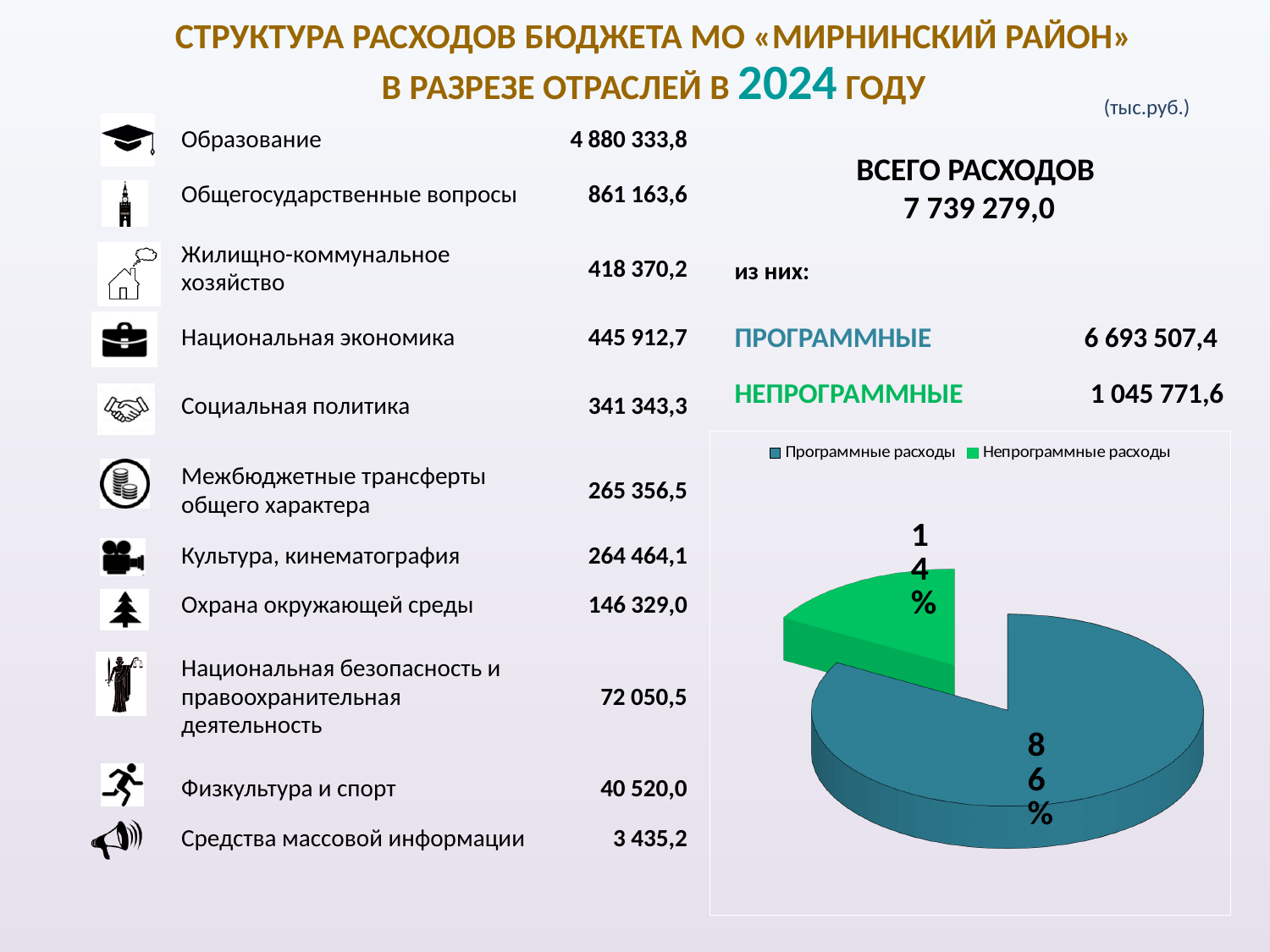
Which is larger in the pie chart: Программные расходы or Непрограммные расходы? Программные расходы Which slice of the pie chart is the smallest? Непрограммные расходы What kind of chart is shown on the slide? pie chart What colour is the Непрограммные расходы slice in the pie chart? green What share of the pie chart is labelled for Программные расходы? 86% How many entries does the legend of the pie chart list? 2 What share of the pie chart is labelled for Непрограммные расходы? 14% By how many percentage points does the Программные расходы slice exceed the Непрограммные расходы slice? 72 What colour is the Программные расходы slice in the pie chart? blue How many slices does the pie chart have? 2 Which slice of the pie chart is the largest? Программные расходы